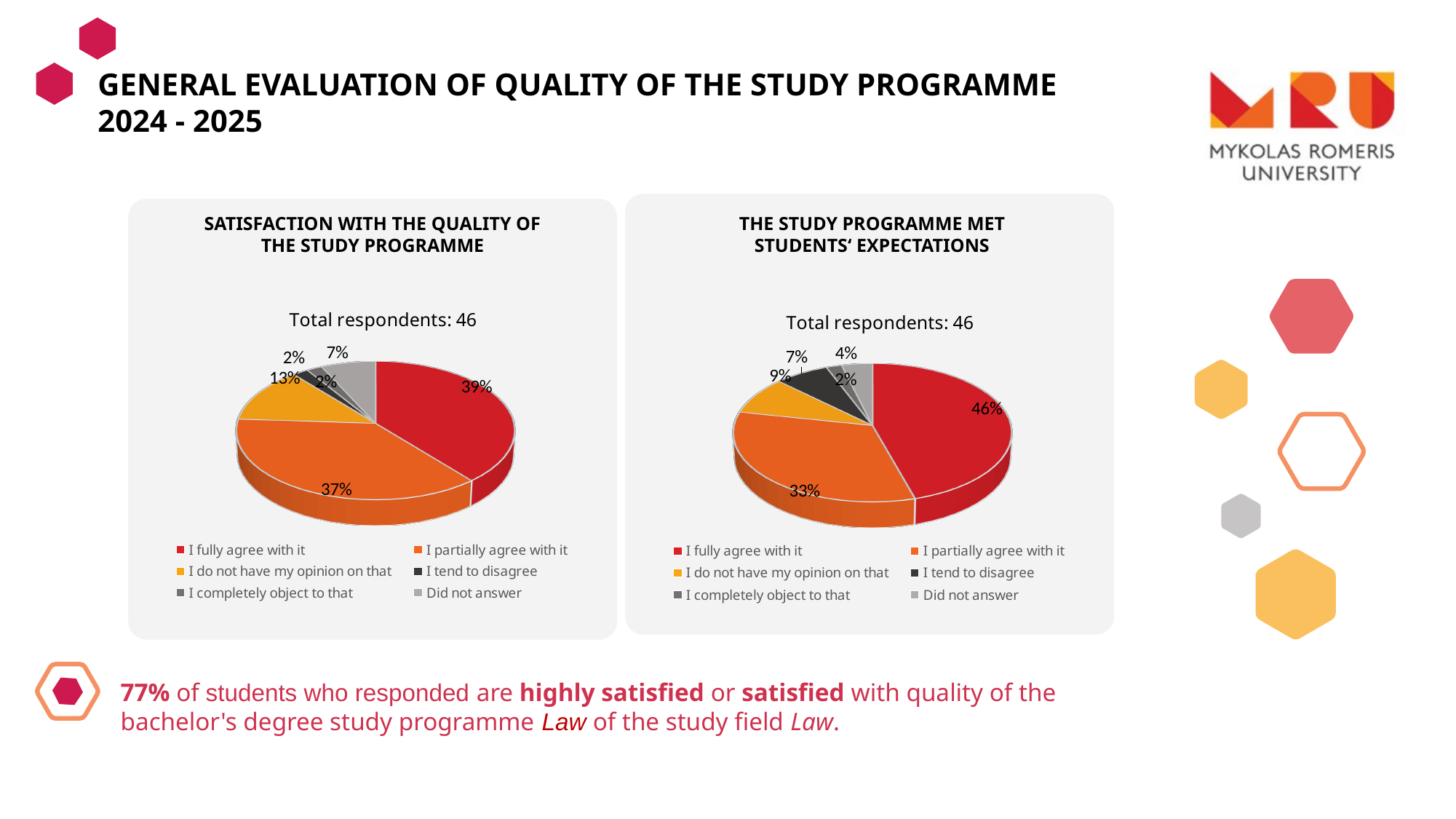
In the 'Satisfaction with the quality of the study programme' chart, which is larger: 'I do not have my opinion on that' or 'Did not answer'? I do not have my opinion on that What type of chart is used in the 'Satisfaction with the quality of the study programme' panel? Pie chart How many total respondents are reported for the 'The study programme met students' expectations' chart? 46 In the 'Satisfaction with the quality of the study programme' chart, what share of respondents chose 'I partially agree with it'? 37% In the 'The study programme met students' expectations' chart, which response has the largest share? I fully agree with it In the 'The study programme met students' expectations' chart, what share of respondents chose 'I fully agree with it'? 46% In the 'The study programme met students' expectations' chart, what share of respondents chose 'I partially agree with it'? 33% In the 'The study programme met students' expectations' chart, what share of respondents chose 'I do not have my opinion on that'? 9% In the 'Satisfaction with the quality of the study programme' chart, what share of respondents chose 'I do not have my opinion on that'? 13% In the 'Satisfaction with the quality of the study programme' chart, what share of respondents did not answer? 7% In the 'Satisfaction with the quality of the study programme' chart, what share of respondents chose 'I fully agree with it'? 39% In the 'The study programme met students' expectations' chart, what is the difference between the 'I fully agree with it' and 'I partially agree with it' shares? 13%